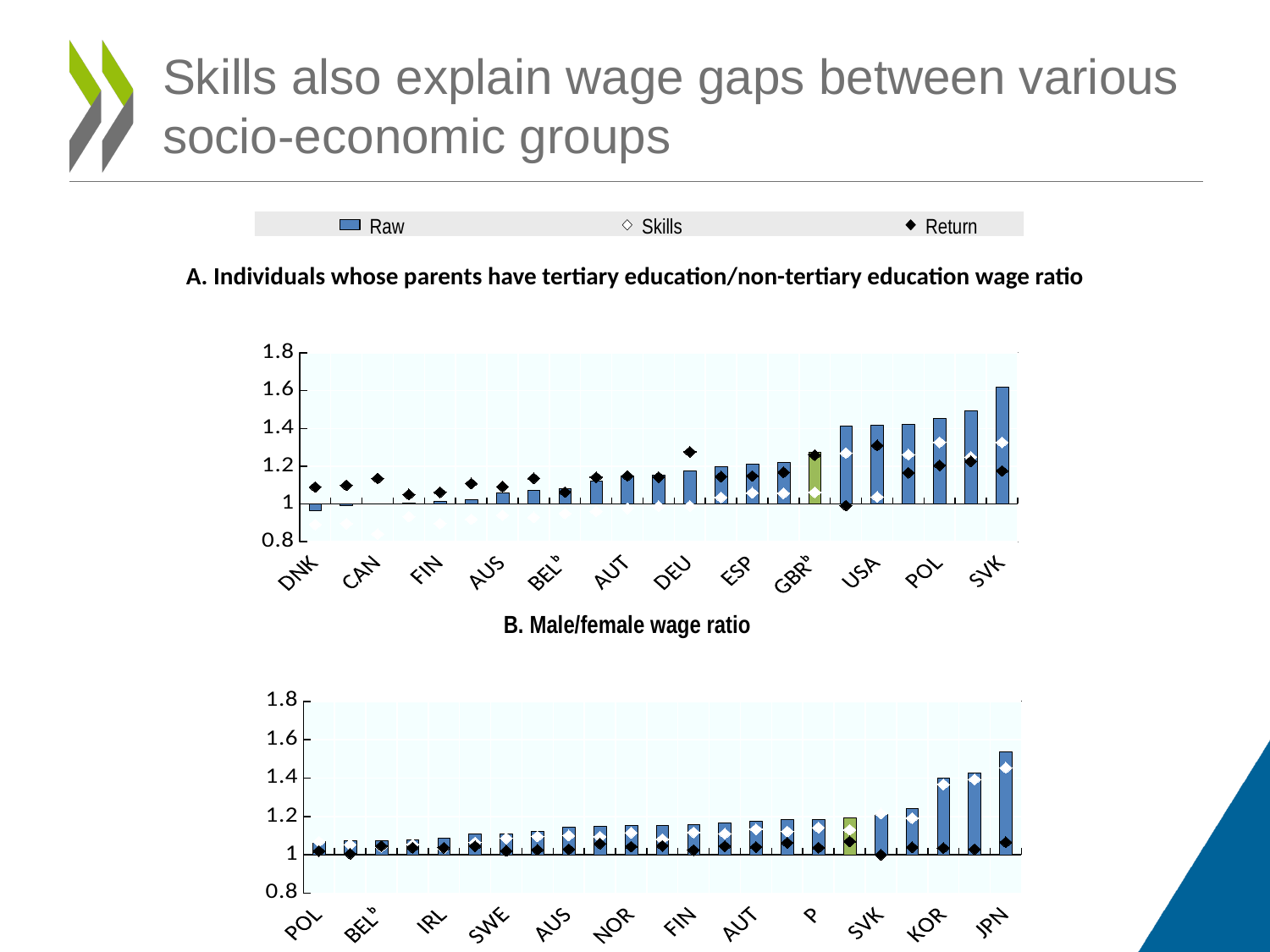
In chart B, is the Raw value for POL greater or less than 1.2? less In chart B (Male/female wage ratio), which labelled country has the highest Raw bar? JPN How many series does the legend list? 3 In chart A, which has the larger Raw value, USA or DNK? USA In chart B, do the Raw bars generally rise or fall from left to right? rise In chart A, which labelled country has the highest Raw bar? SVK What is the title of the lower chart? B. Male/female wage ratio What are the three series named in the legend? Raw, Skills, Return In chart A, is the Raw value for DNK greater or less than 1.2? less In chart B, is the Raw value for JPN greater or less than 1.4? greater What kind of chart is chart A (Individuals whose parents have tertiary education/non-tertiary education wage ratio)? bar chart